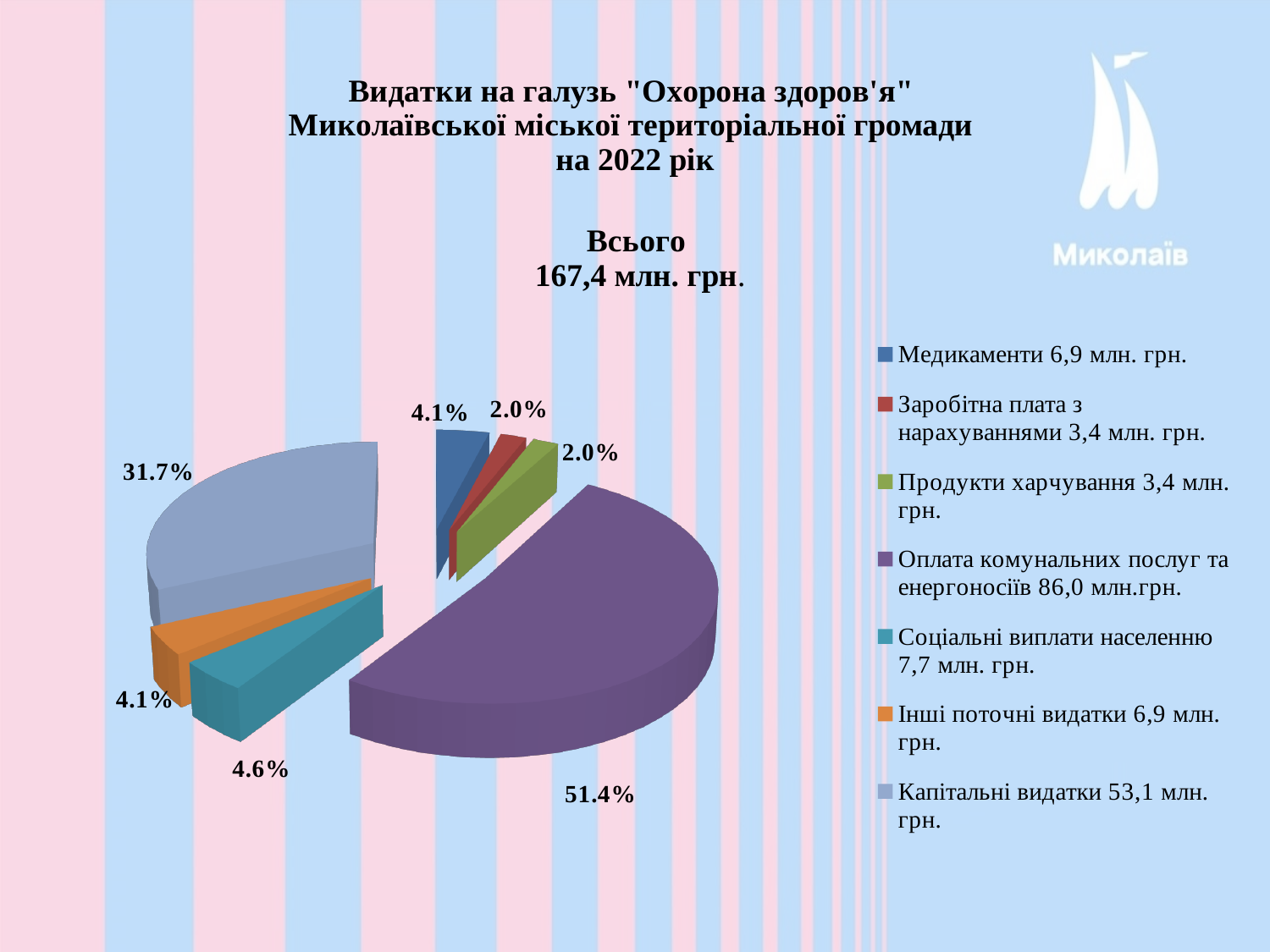
Which is larger: the share for "Капітальні видатки" or the share for "Медикаменти"? Капітальні видатки What share of the pie does "Оплата комунальних послуг та енергоносіїв" take? 51.4% Which category has the largest slice of the pie? Оплата комунальних послуг та енергоносіїв What share of the pie does "Капітальні видатки" take? 31.7% What is the amount in the legend for "Соціальні виплати населенню"? 7,7 млн. грн. What kind of chart is shown on the slide? pie chart What share of the pie does "Соціальні виплати населенню" take? 4.6% How many slices does the pie chart have? 7 What is the difference in percentage points between the "Оплата комунальних послуг та енергоносіїв" slice and the "Капітальні видатки" slice? 19.7 What is the amount in the legend for "Капітальні видатки"? 53,1 млн. грн. How many entries does the legend list? 7